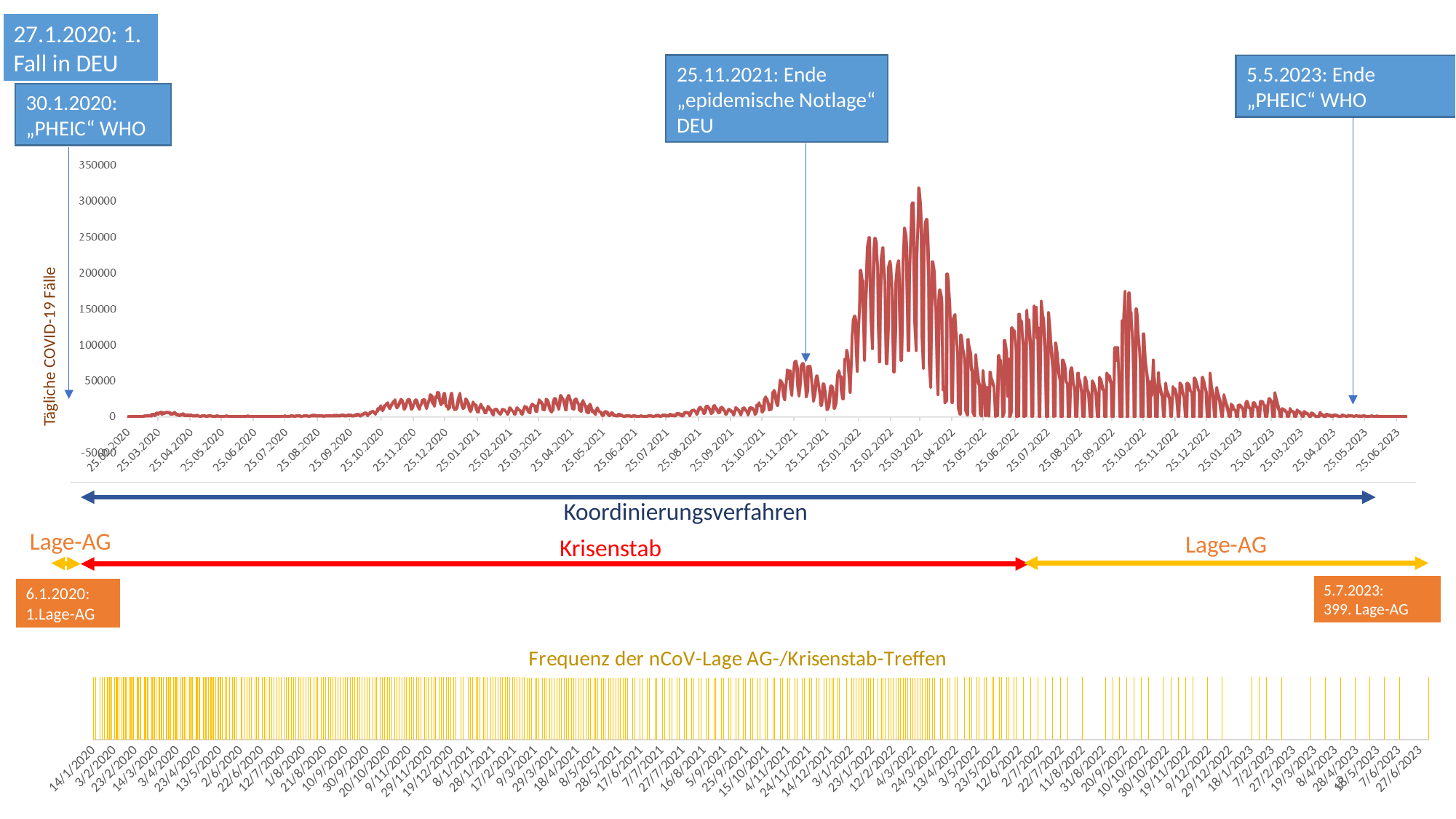
In the top chart, do daily cases rise or fall between 25.09.2021 and 25.11.2021? rise In the top chart, do daily cases rise or fall between 25.03.2022 and 25.05.2022? fall What kind of chart is the top chart showing Tägliche COVID-19 Fälle? line chart In the top chart, is the value of daily cases around 25.12.2020 greater or less than 50000? less In the top chart, near which x-axis date does the highest peak of daily cases occur? 25.03.2022 In the top chart, what is the label of the vertical axis? Tägliche COVID-19 Fälle In the top chart, which peak is higher: the one around 25.03.2022 or the one around 25.10.2022? 25.03.2022 In the top chart, which peak is higher: the one around 25.12.2020 or the one around 25.10.2022? 25.10.2022 In the top chart, is the value of daily cases around 25.06.2023 greater or less than 50000? less In the top chart, is the highest peak of daily cases greater or less than 300000? greater What is the title of the bottom chart? Frequenz der nCoV-Lage AG-/Krisenstab-Treffen